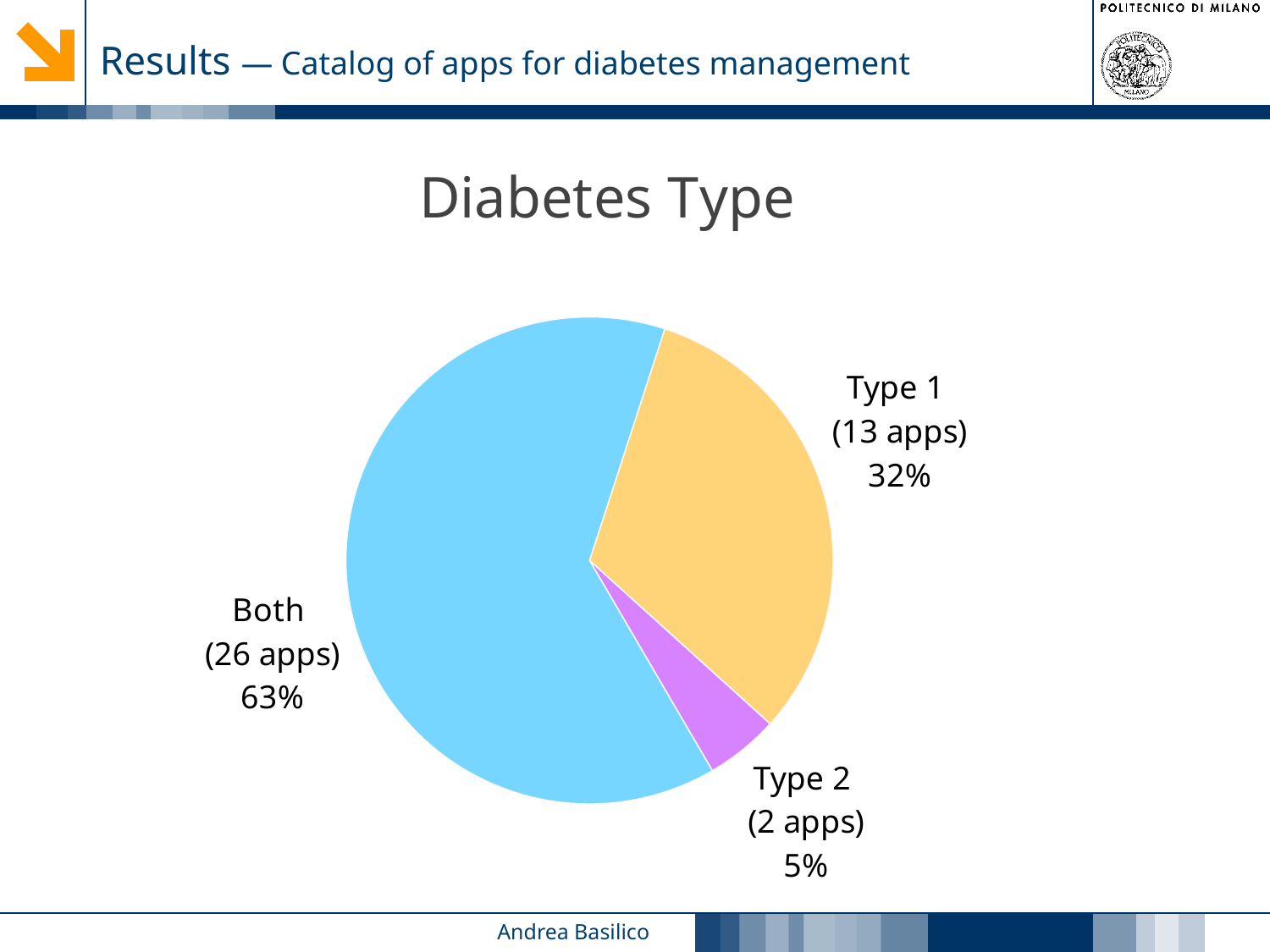
Which category has the largest slice? Both How many apps are in the Both slice? 26 apps What is the difference in number of apps between Both and Type 1? 13 apps How many slices does the pie chart have? 3 Which category has the smallest slice? Type 2 How many apps are in the Type 2 slice? 2 apps What share of the pie does the Type 1 slice represent? 32% How many apps are in the Type 1 slice? 13 apps What share of the pie does the Both slice represent? 63% What is the title of the chart? Diabetes Type Which has more apps, Type 1 or Type 2? Type 1 What kind of chart is shown on the slide? pie chart